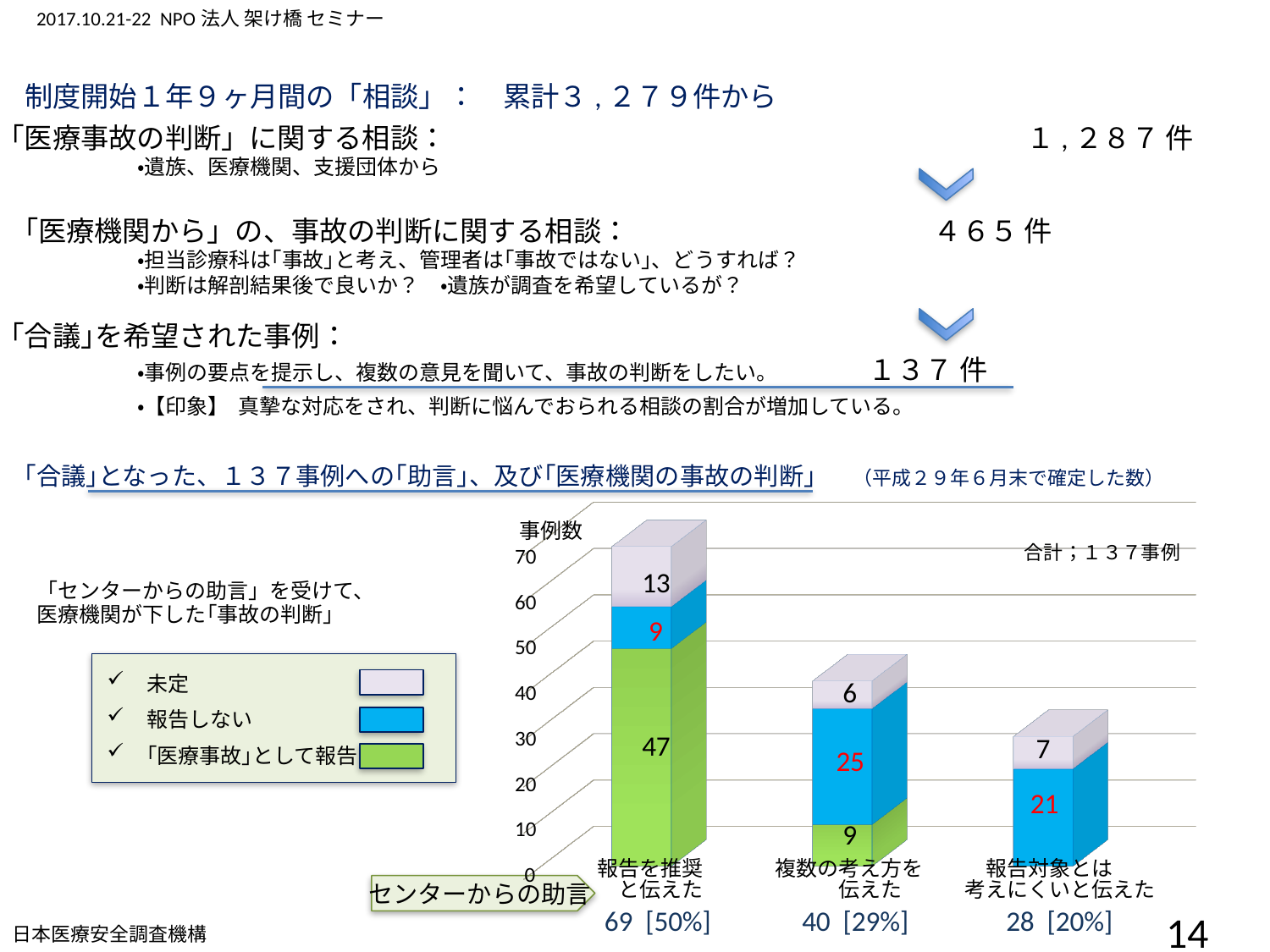
What is the total of the stacked bar for 報告を推奨と伝えた? 69 How many categories are plotted on the x axis of the chart? 3 How many series does the legend list for the chart? 3 What is the value of 未定 for the category 報告対象とは考えにくいと伝えた? 7 Which colour represents 未定 in the legend? grey Which category has the lowest total? 報告対象とは考えにくいと伝えた What is the total of the stacked bar for 報告対象とは考えにくいと伝えた? 28 What is the value of 「医療事故」として報告 for the category 報告を推奨と伝えた? 47 What is the difference between the 報告しない values for 複数の考え方を伝えた and 報告を推奨と伝えた? 16 Which category has the highest total? 報告を推奨と伝えた What kind of chart is shown on the slide? stacked bar chart What is the value of 報告しない for the category 複数の考え方を伝えた? 25